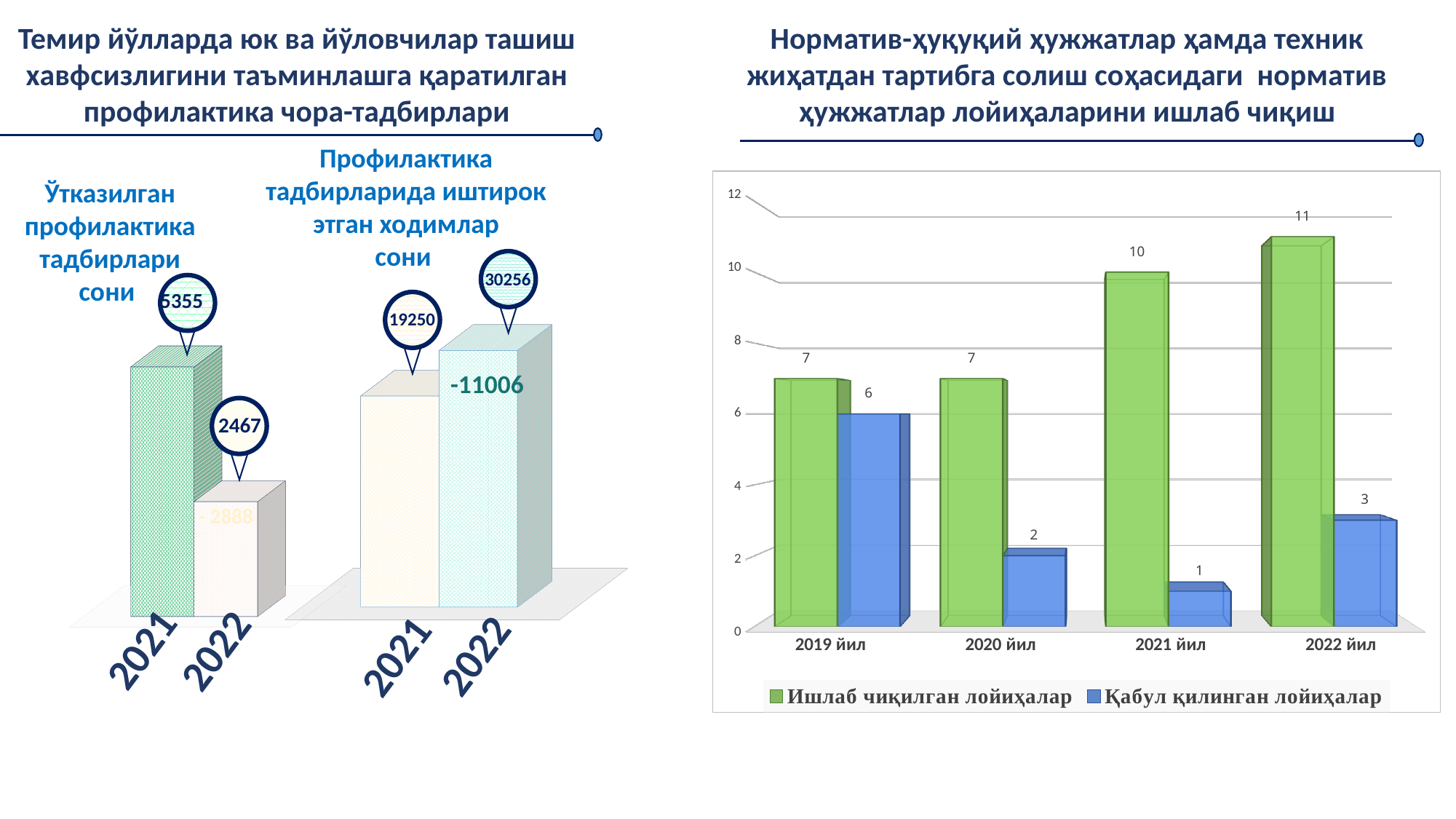
What kind of chart is shown on the right side of the slide? bar chart In the chart on the right, does the value for Ишлаб чиқилган лойиҳалар rise or fall from 2020 йил to 2022 йил? rise In the chart on the right, what is the value for Ишлаб чиқилган лойиҳалар in 2021 йил? 10 In the chart on the right, how many years are shown on the x axis? 4 In the chart on the right, which year has the lowest value for Қабул қилинган лойиҳалар? 2021 йил In the chart on the right, which year has the highest value for Ишлаб чиқилган лойиҳалар? 2022 йил In the chart titled 'Ўтказилган профилактика тадбирлари сони' on the left, what is the value for 2021? 5355 In the chart on the right, what is the difference between Ишлаб чиқилган лойиҳалар and Қабул қилинган лойиҳалар in 2022 йил? 8 In the chart titled 'Ўтказилган профилактика тадбирлари сони' on the left, which year has the larger value, 2021 or 2022? 2021 In the chart on the right, how many series does the legend list? 2 In the chart on the right, what is the value for Қабул қилинган лойиҳалар in 2020 йил? 2 In the chart titled 'Профилактика тадбирларида иштирок этган ходимлар сони' on the left, what is the value for 2022? 30256